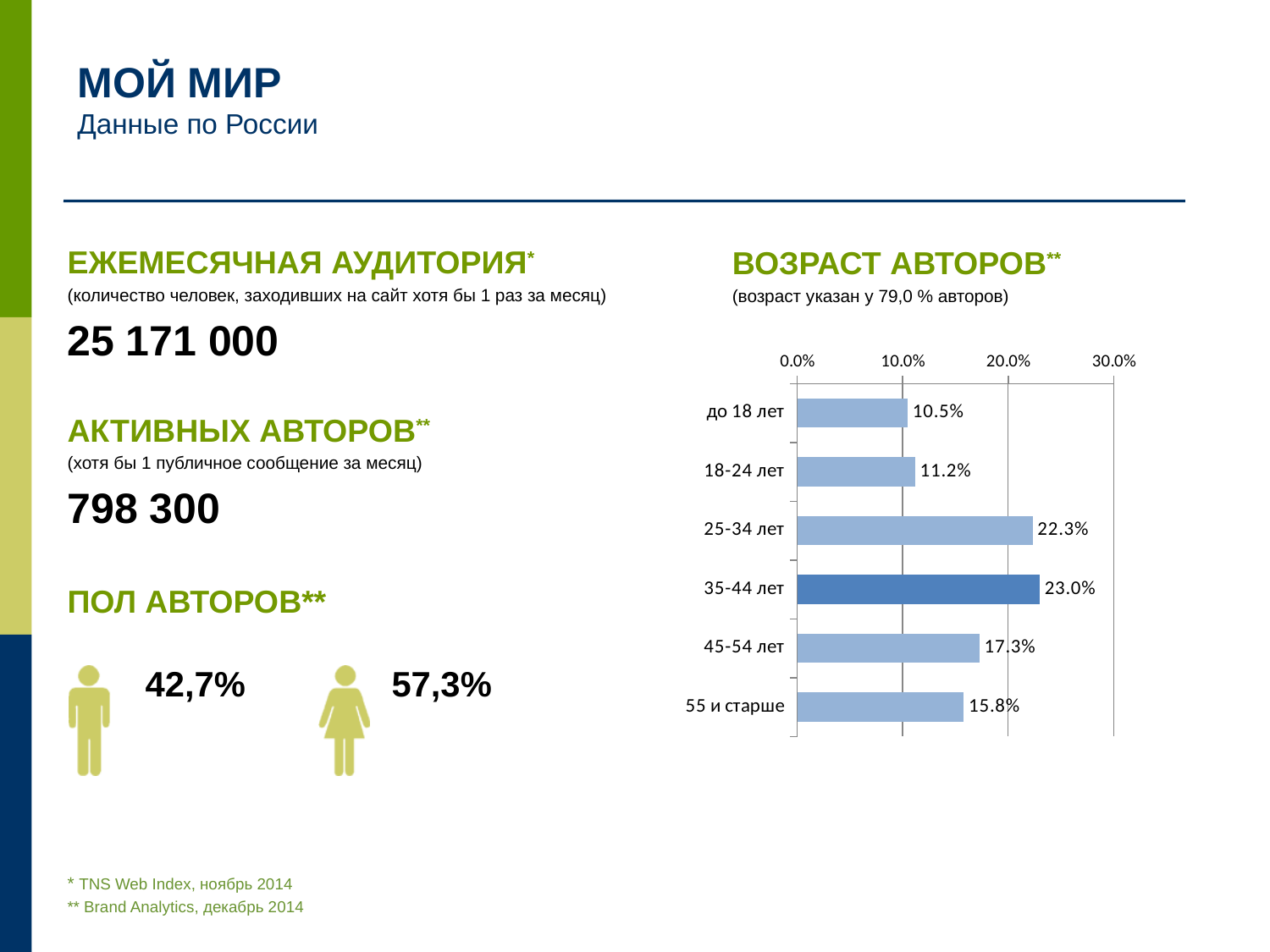
What is the value for the 55 и старше category in the ВОЗРАСТ АВТОРОВ chart? 15.8% What is the value for the до 18 лет category in the ВОЗРАСТ АВТОРОВ chart? 10.5% What is the difference between the values for 25-34 лет and 18-24 лет in the ВОЗРАСТ АВТОРОВ chart? 11.1% Which age group has the lowest value in the ВОЗРАСТ АВТОРОВ chart? до 18 лет What is the value for the 25-34 лет category in the ВОЗРАСТ АВТОРОВ chart? 22.3% Which age group has the highest value in the ВОЗРАСТ АВТОРОВ chart? 35-44 лет What kind of chart is the ВОЗРАСТ АВТОРОВ chart? bar chart How many age categories are shown in the ВОЗРАСТ АВТОРОВ chart? 6 In the ВОЗРАСТ АВТОРОВ chart, which is larger: the value for 18-24 лет or the value for 55 и старше? 55 и старше What is the highest tick value shown on the axis of the ВОЗРАСТ АВТОРОВ chart? 30.0% What is the difference between the values for 35-44 лет and 45-54 лет in the ВОЗРАСТ АВТОРОВ chart? 5.7% In the ВОЗРАСТ АВТОРОВ chart, is the value for 45-54 лет greater or less than 20.0%? less